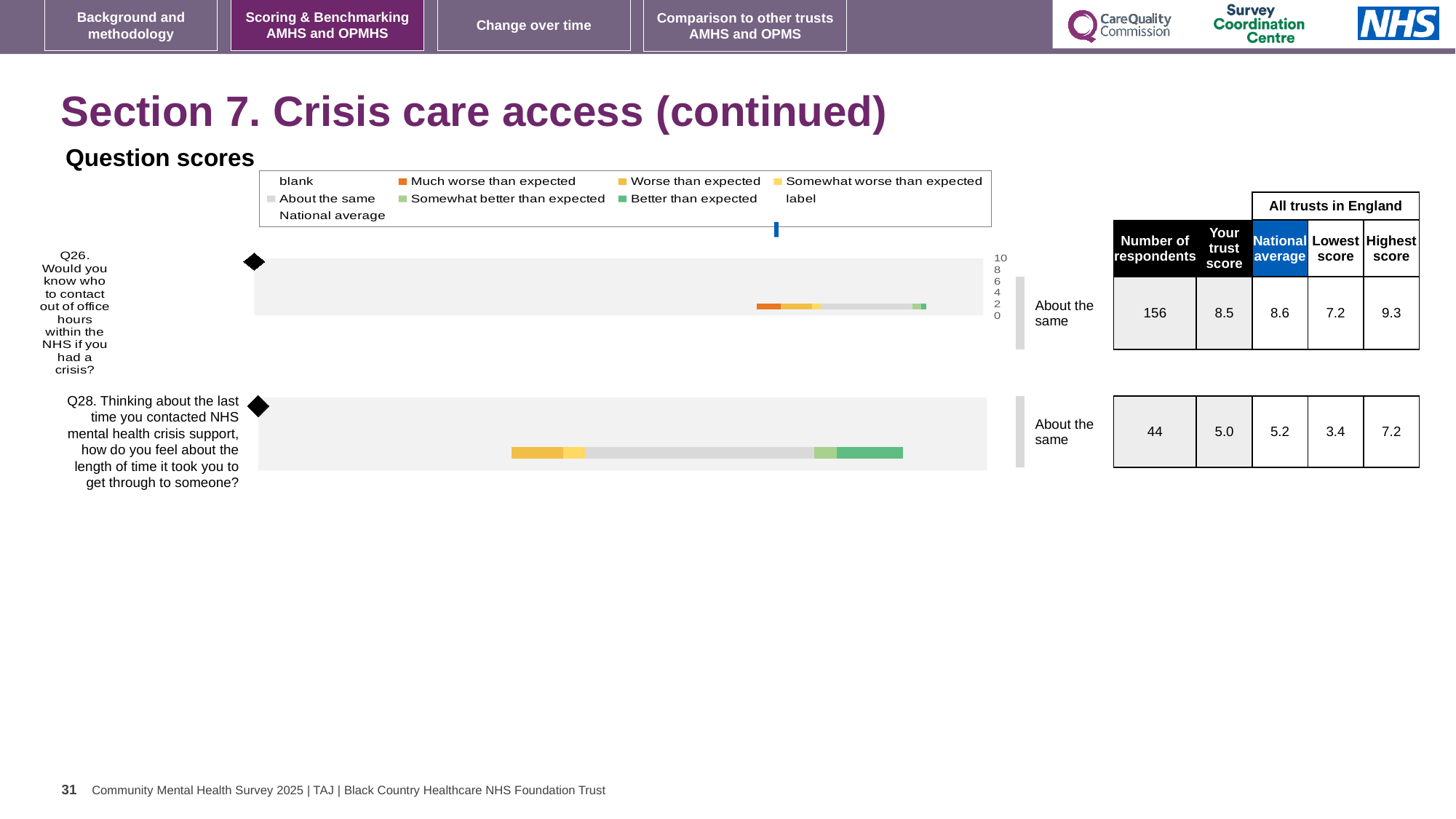
What is the trust score for Q26 (Would you know who to contact out of office hours within the NHS if you had a crisis?)? 8.5 What kind of chart is used to show the question scores on this slide? bar chart How many respondents answered Q28? 44 What is the difference between the highest and lowest scores for Q28? 3.8 What is the highest score among all trusts in England for Q26? 9.3 What is the lowest score among all trusts in England for Q28? 3.4 What benchmark category is shown for Q28? About the same Which question has the higher trust score, Q26 or Q28? Q26 What is the difference between the national average and the trust score for Q26? 0.1 How many questions are plotted on this slide? 2 What is the national average for Q28 (length of time it took to get through to someone)? 5.2 How many respondents answered Q26? 156